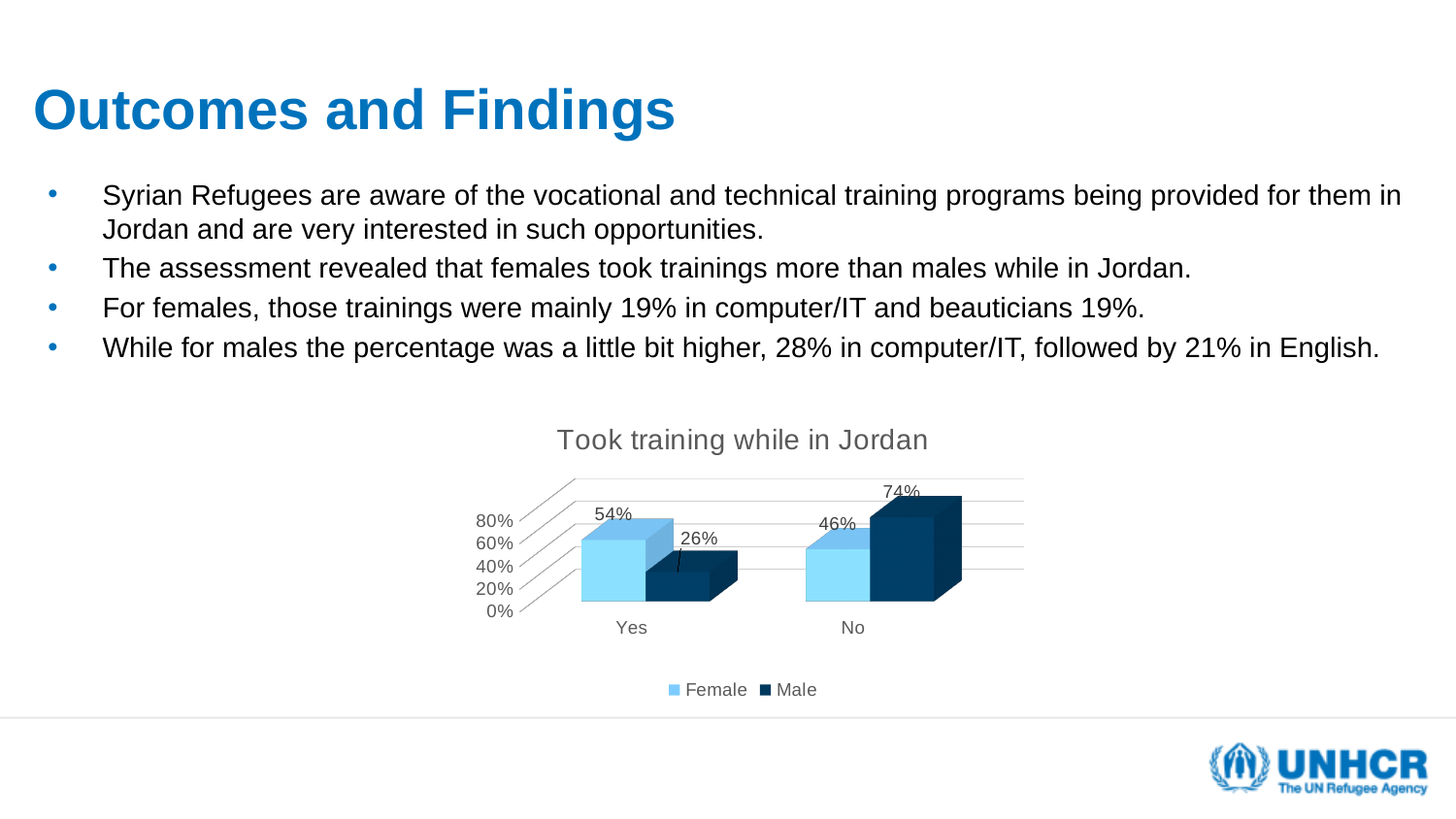
Which category has the highest Male value in the chart? No Which category has the lowest Female value in the chart? No For the Yes category, which series has the larger value, Female or Male? Female What is the Female value for Yes in the 'Took training while in Jordan' chart? 54% What is the Male value for Yes in the 'Took training while in Jordan' chart? 26% What is the Female value for No in the 'Took training while in Jordan' chart? 46% What is the difference between the Female and Male values for Yes? 28% How many series does the chart legend list? 2 What is the difference between the Male values for No and Yes? 48% What is the Male value for No in the 'Took training while in Jordan' chart? 74% What type of chart is shown on the slide? Bar chart How many categories are shown on the x axis of the chart? 2